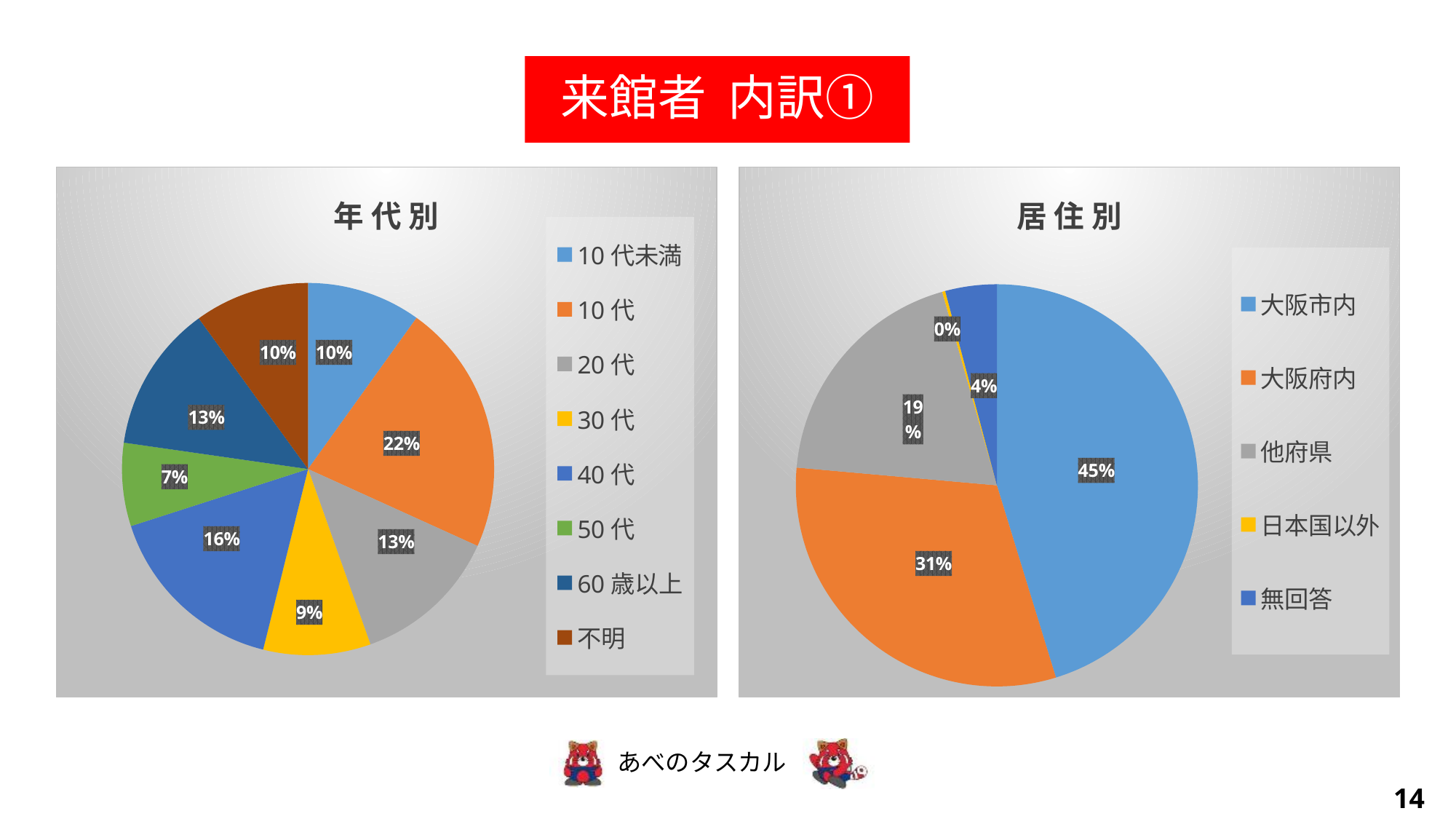
In the 居住別 chart, what share is labelled for 無回答? 4% In the 年代別 chart, which age group has the smallest slice? 50 代 In the 居住別 chart, what share is labelled for 大阪府内? 31% In the 居住別 chart, which category has the largest slice? 大阪市内 In the 年代別 chart, which age group has the largest slice? 10 代 In the 年代別 chart, what is the difference between the shares for 10 代 and 30 代? 13% What type of chart is used for 居住別? Pie chart In the 居住別 chart, which is larger, 他府県 or 無回答? 他府県 In the 年代別 chart, how many categories does the legend list? 8 In the 年代別 chart, what share is labelled for 10 代? 22% In the 居住別 chart, what is the difference between the shares for 大阪市内 and 大阪府内? 14% In the 年代別 chart, what share is labelled for 40 代? 16%